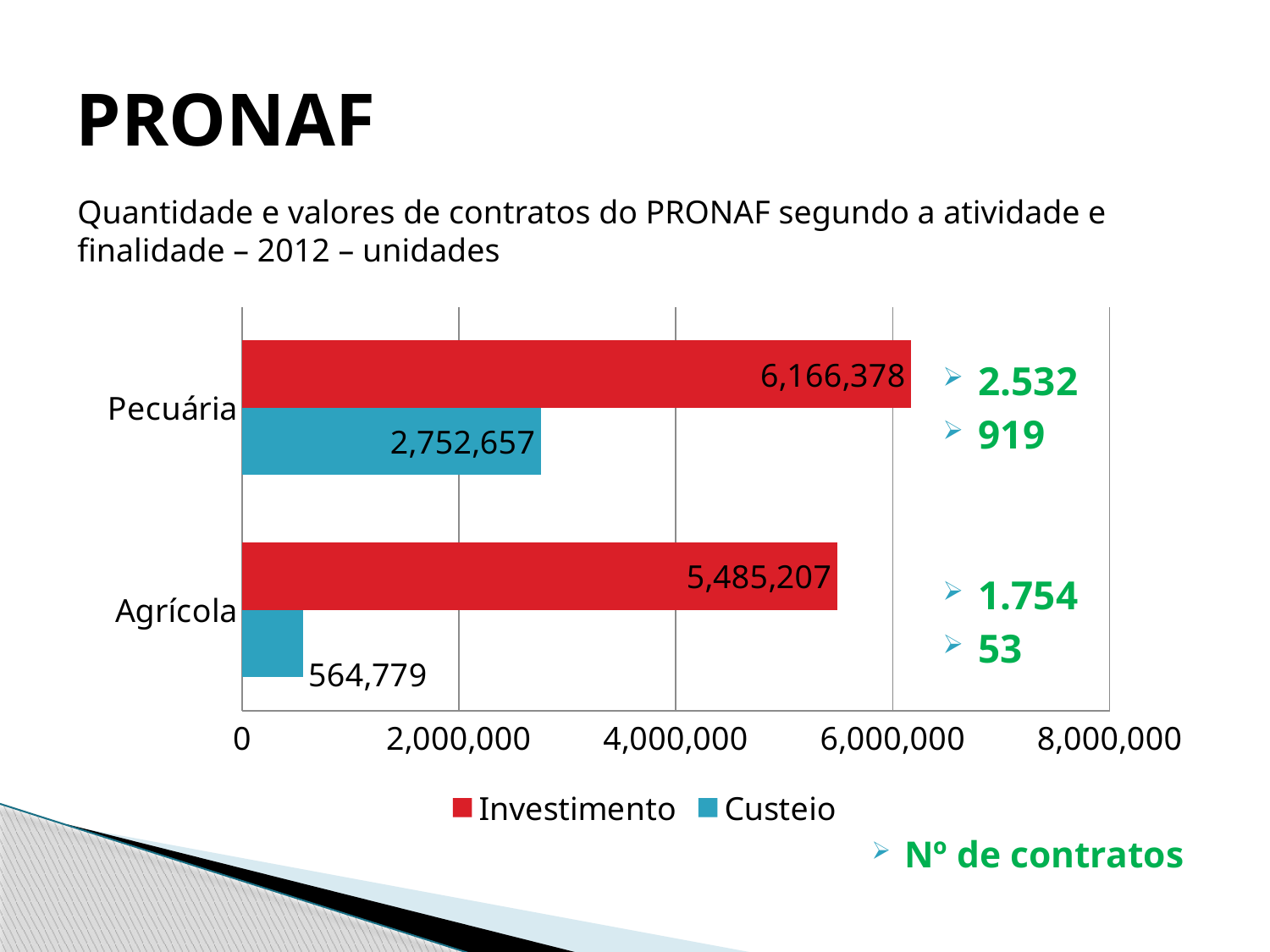
Which category has the highest Investimento value? Pecuária How many categories are shown on the chart? 2 Which is larger for Agrícola, Investimento or Custeio? Investimento What is the difference between the Investimento and Custeio values for Pecuária? 3,413,721 What kind of chart is shown on the slide? Bar chart How many series does the legend list? 2 What is the Custeio value for Pecuária? 2,752,657 What is the Investimento value for Agrícola? 5,485,207 Which category has the lowest Custeio value? Agrícola What is the Investimento value for Pecuária? 6,166,378 What is the Custeio value for Agrícola? 564,779 What is the difference between the Investimento values for Pecuária and Agrícola? 681,171